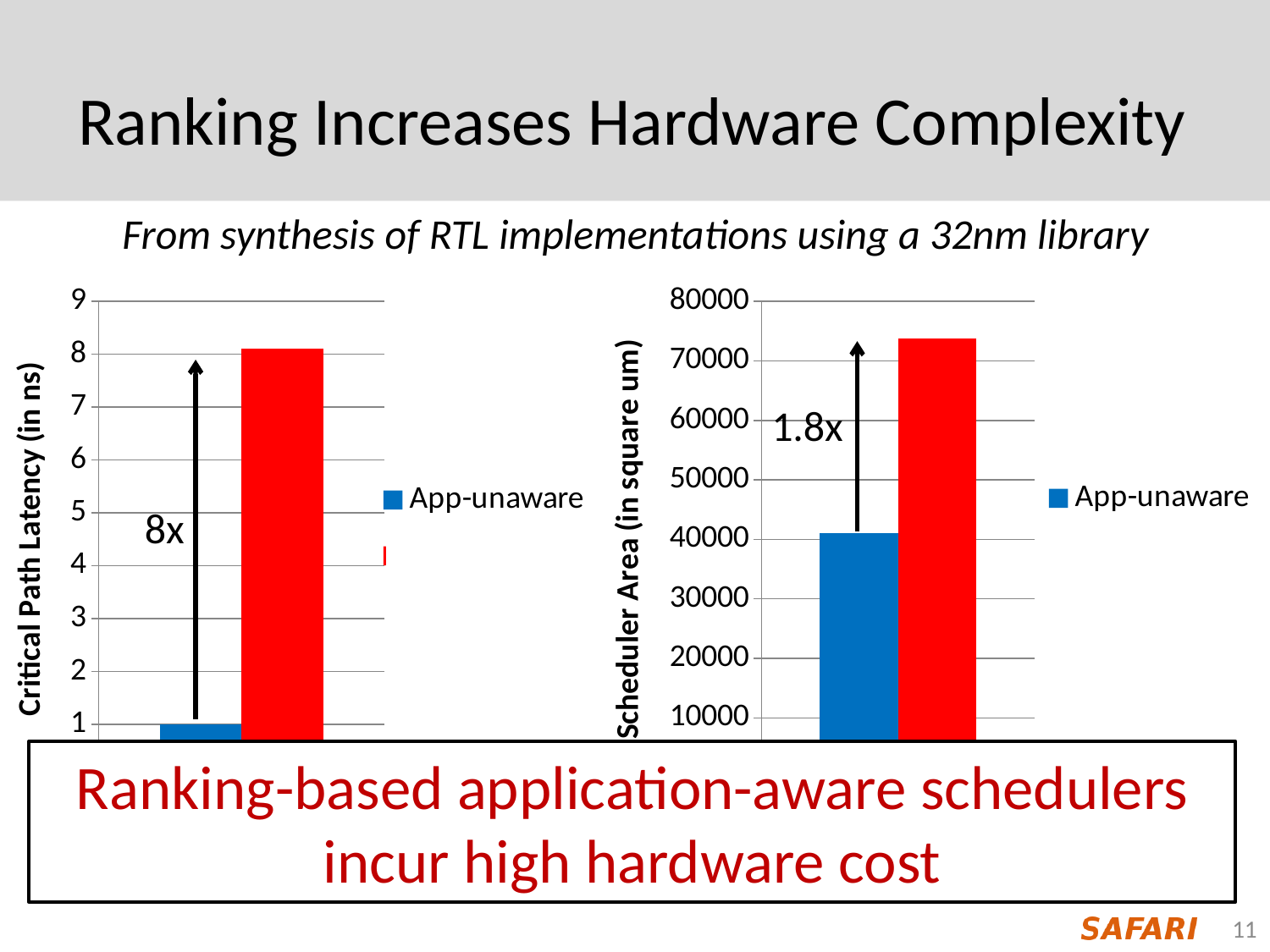
In the right chart, is the value of the red bar greater or less than 70000? greater In the right chart, which bar is taller, the App-unaware bar or the red bar? the red bar In the right chart, is the value for App-unaware greater or less than 50000? less How many bars are plotted in the left chart? 2 What is the y-axis title of the left chart? Critical Path Latency (in ns) What kind of chart is the left chart (Critical Path Latency)? bar chart In the left chart, is the value for App-unaware greater or less than 2? less How many bars are plotted in the right chart? 2 What factor is annotated next to the arrow in the right chart (Scheduler Area)? 1.8x In the left chart, which bar is taller, the App-unaware bar or the red bar? the red bar What kind of chart is the right chart (Scheduler Area)? bar chart